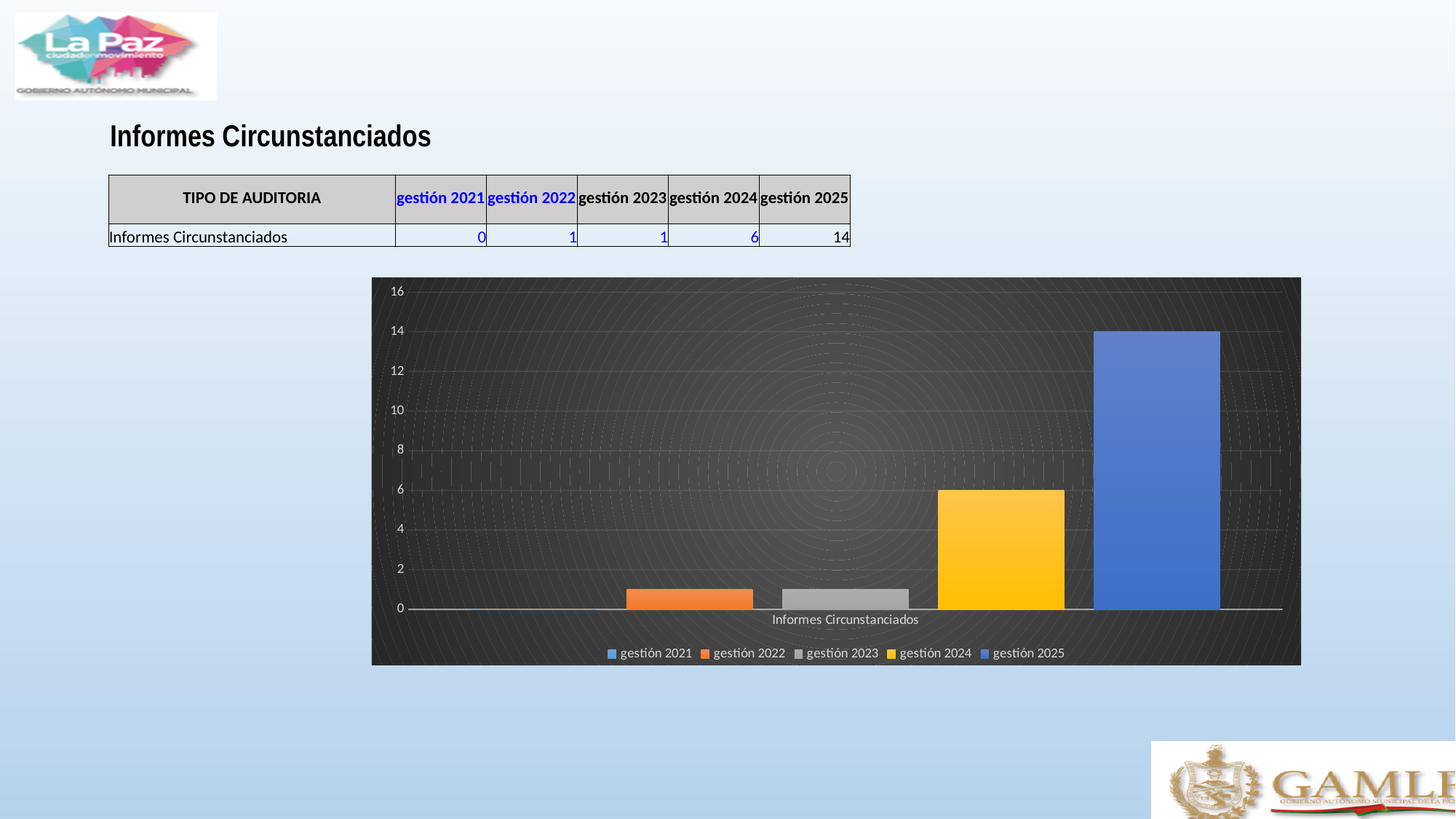
What is the value for gestión 2021 in the chart? 0 Which series has the lowest value in the chart? gestión 2021 What is the value for gestión 2024 in the chart? 6 Is the value for gestión 2025 greater or less than 12? greater Which series has the highest value in the chart? gestión 2025 What category label is shown on the x axis of the chart? Informes Circunstanciados What is the value for gestión 2025 in the chart? 14 What kind of chart is shown on the slide? bar chart What is the difference between the values for gestión 2025 and gestión 2024? 8 How many series does the chart legend list? 5 What is the value for gestión 2022 in the chart? 1 Which is larger, the value for gestión 2024 or the value for gestión 2023? gestión 2024